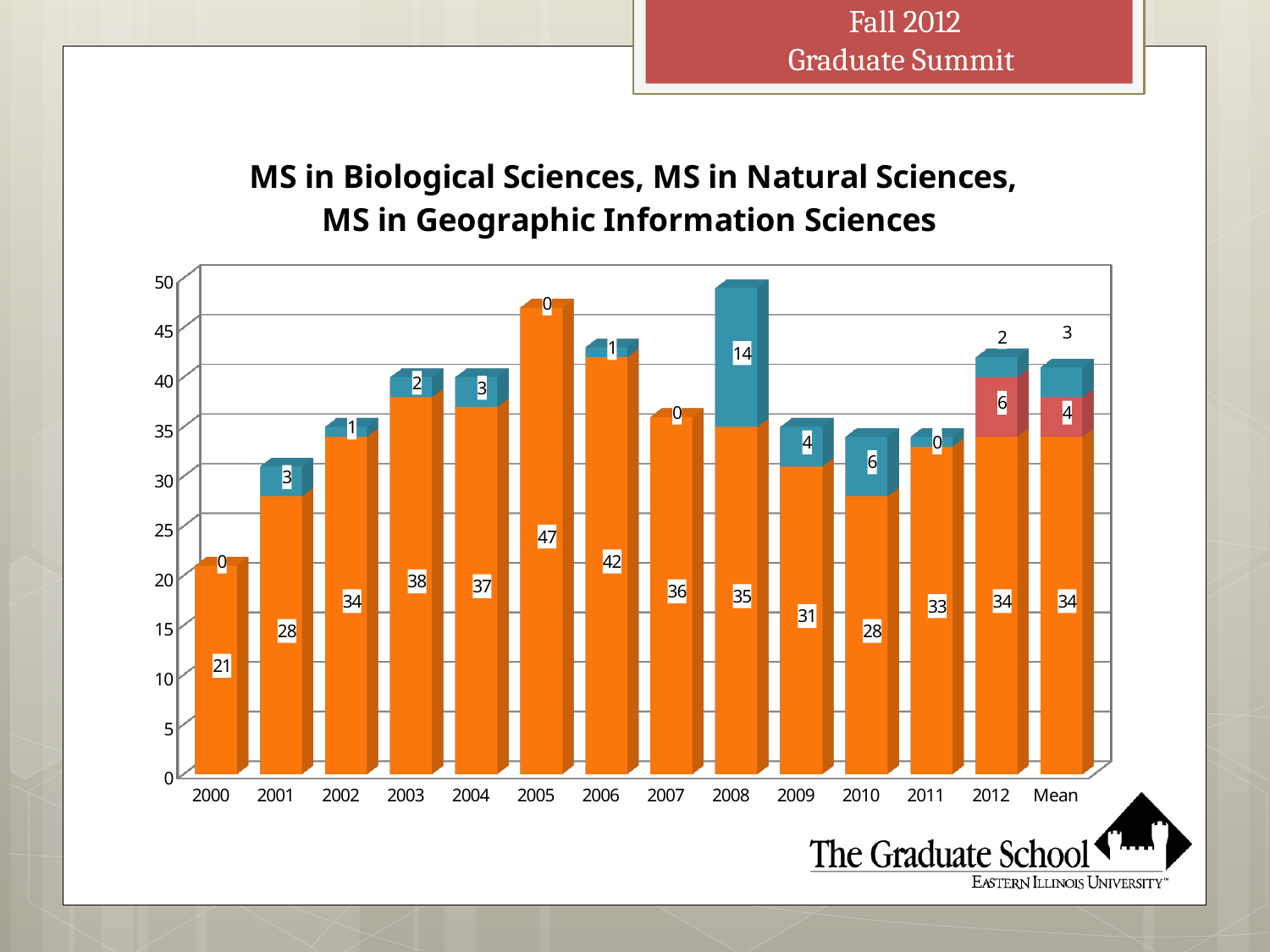
What is the value of the red segment for 2012? 6 How many categories are shown on the x axis? 14 What is the total height of the stacked bar for 2012? 42 What is the total height of the stacked bar for 2008? 49 What is the value of the blue segment for 2008? 14 Which year has the highest value for the orange segment? 2005 What kind of chart is shown on the slide? Stacked bar chart Do the orange segment values rise or fall from 2000 to 2005? Rise What is the difference between the orange segment values for 2005 and 2000? 26 Which year has the lowest value for the orange segment? 2000 What is the value of the orange segment for 2005? 47 Which is larger, the orange segment for 2006 or for 2007? 2006